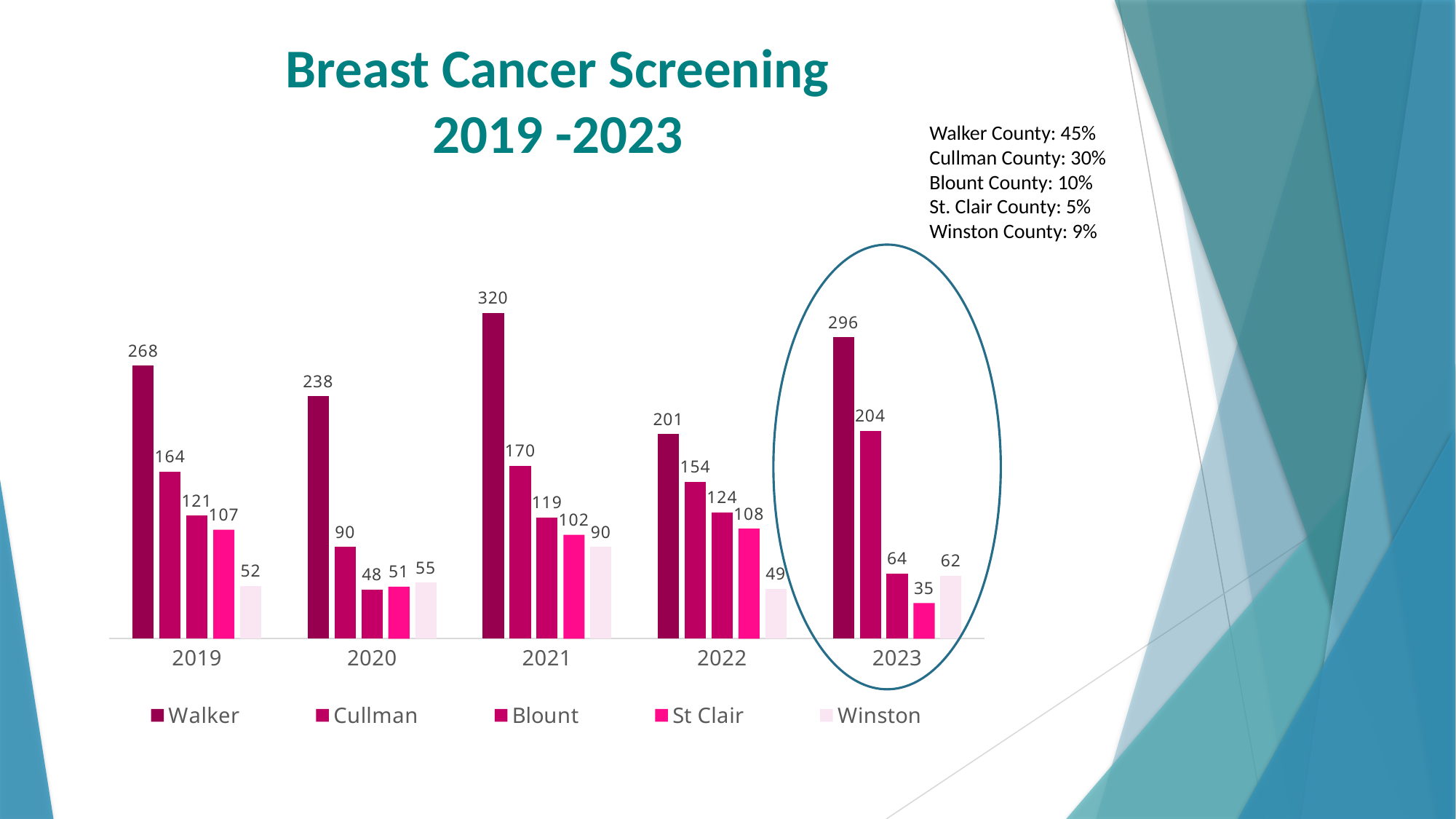
How many series does the legend list? 5 Which is larger, the Blount value in 2019 or the Blount value in 2021? 2019 What is the difference between the Walker values for 2021 and 2022? 119 How many years are shown on the x axis? 5 In which year is the Walker value highest? 2021 What is the value for Winston in 2020? 55 What is the value for St Clair in 2023? 35 In which year is the Cullman value lowest? 2020 What kind of chart is shown on the slide? bar chart What is the value for Walker in 2021? 320 Does the Cullman value rise or fall from 2022 to 2023? rise What is the title of the chart? Breast Cancer Screening 2019 -2023